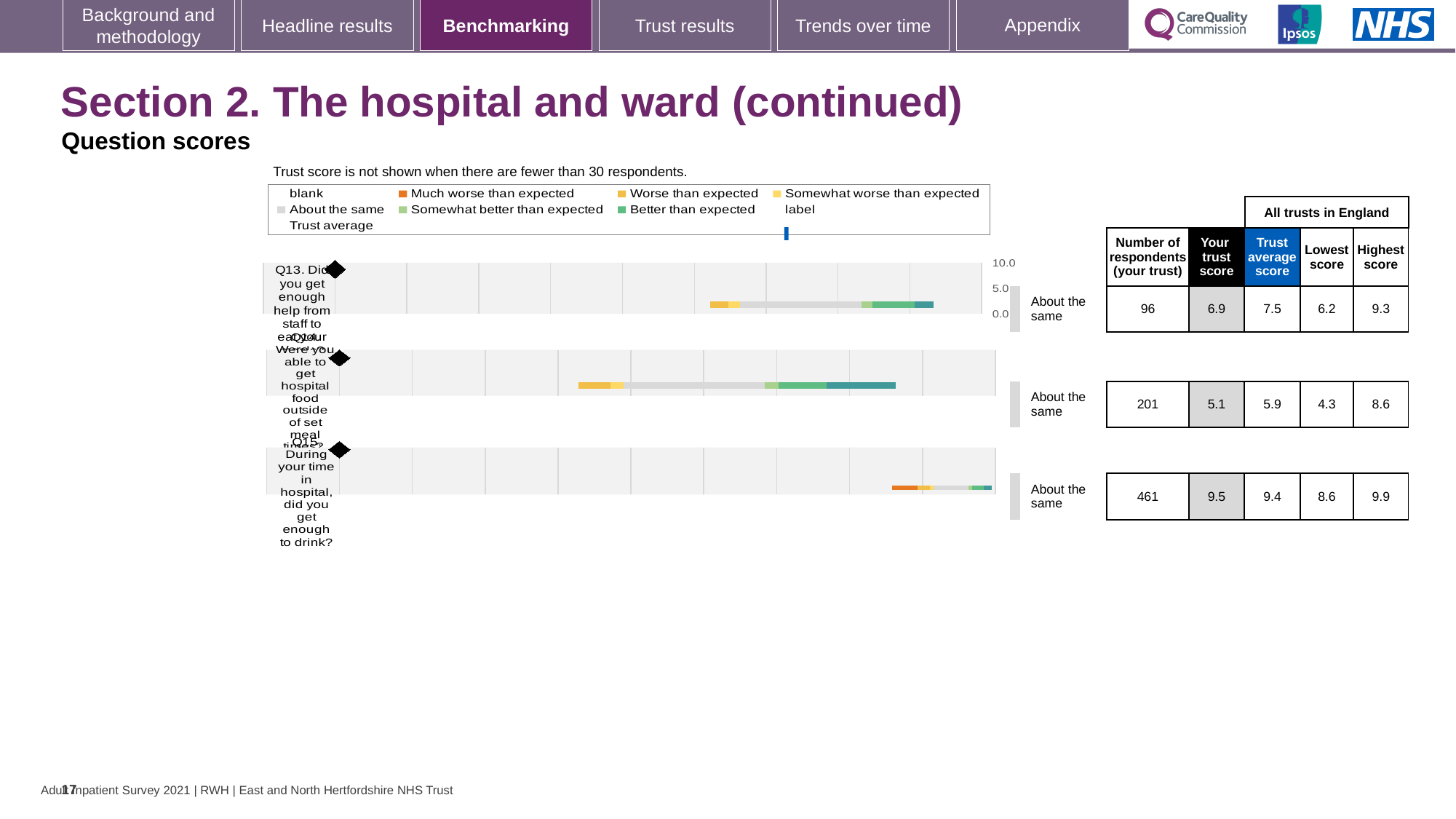
What kind of chart is used to show the question scores on this slide? bar chart How many respondents answered Q14 (Were you able to get hospital food outside of set meal times?)? 201 What is the difference between the trust average score and 'Your trust score' for Q13? 0.6 What benchmark category is shown for Q14 next to the chart? About the same What is the 'Your trust score' value for Q13 (Did you get enough help from staff to eat your meals?)? 6.9 How many questions (categories) are plotted in the chart? 3 For Q14, which is larger: 'Your trust score' or the trust average score? Trust average score Which question has the highest 'Your trust score'? Q15 Which question has the lowest 'Your trust score'? Q14 What is the highest score across all trusts in England for Q15 (did you get enough to drink?)? 9.9 What is the total number of respondents across Q13, Q14 and Q15? 758 What is the trust average score for Q14? 5.9